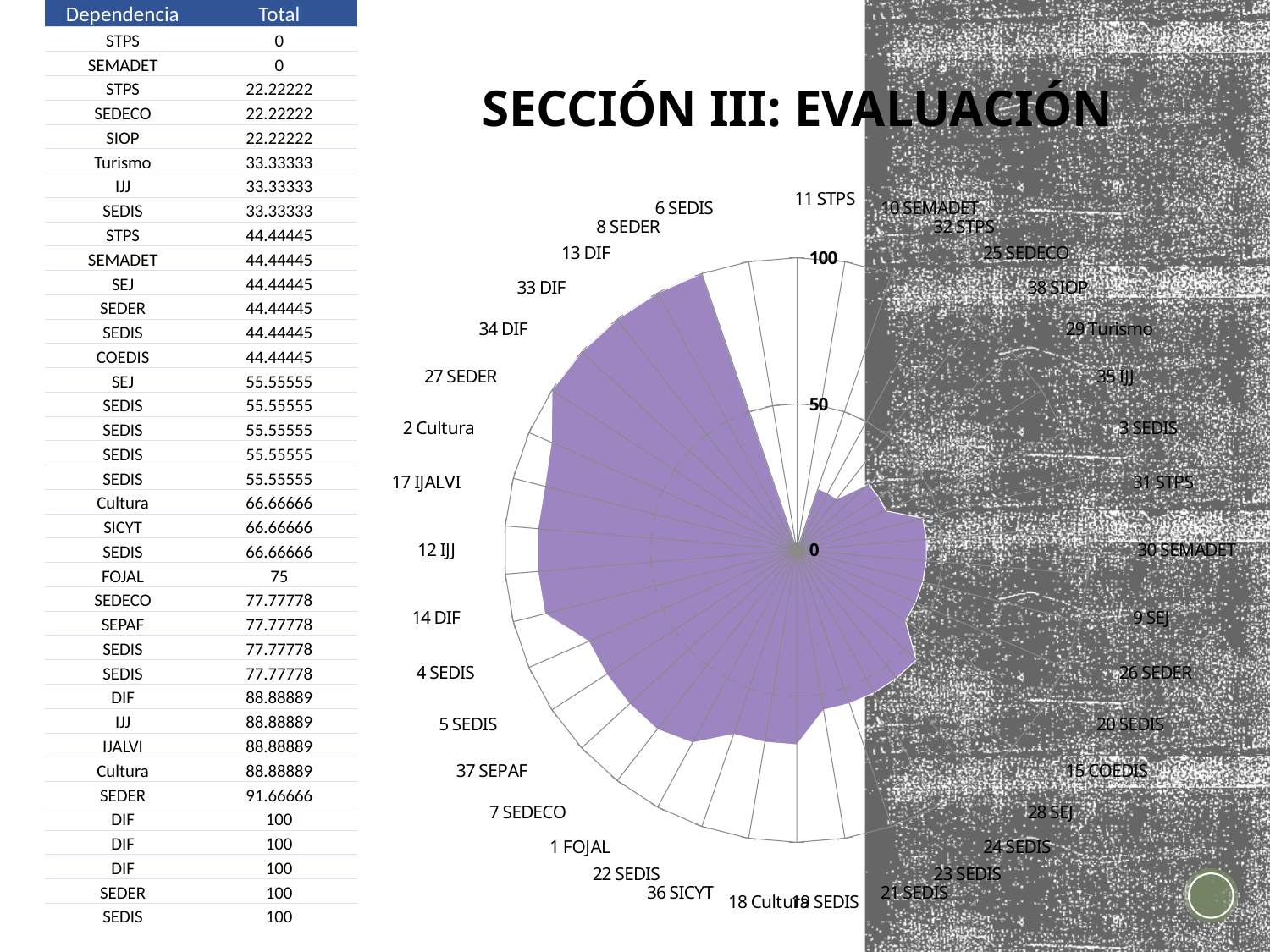
Is the value for 11 STPS greater or less than 50? less Is the value for 6 SEDIS greater or less than 50? greater Is the value for 3 SEDIS greater or less than 50? less Which has the larger value, 6 SEDIS or 11 STPS? 6 SEDIS What colour is the filled area of the radar chart? purple What is the highest value shown on the chart's radial axis? 100 What kind of chart is shown on the slide? radar chart Which has the larger value, 33 DIF or 3 SEDIS? 33 DIF